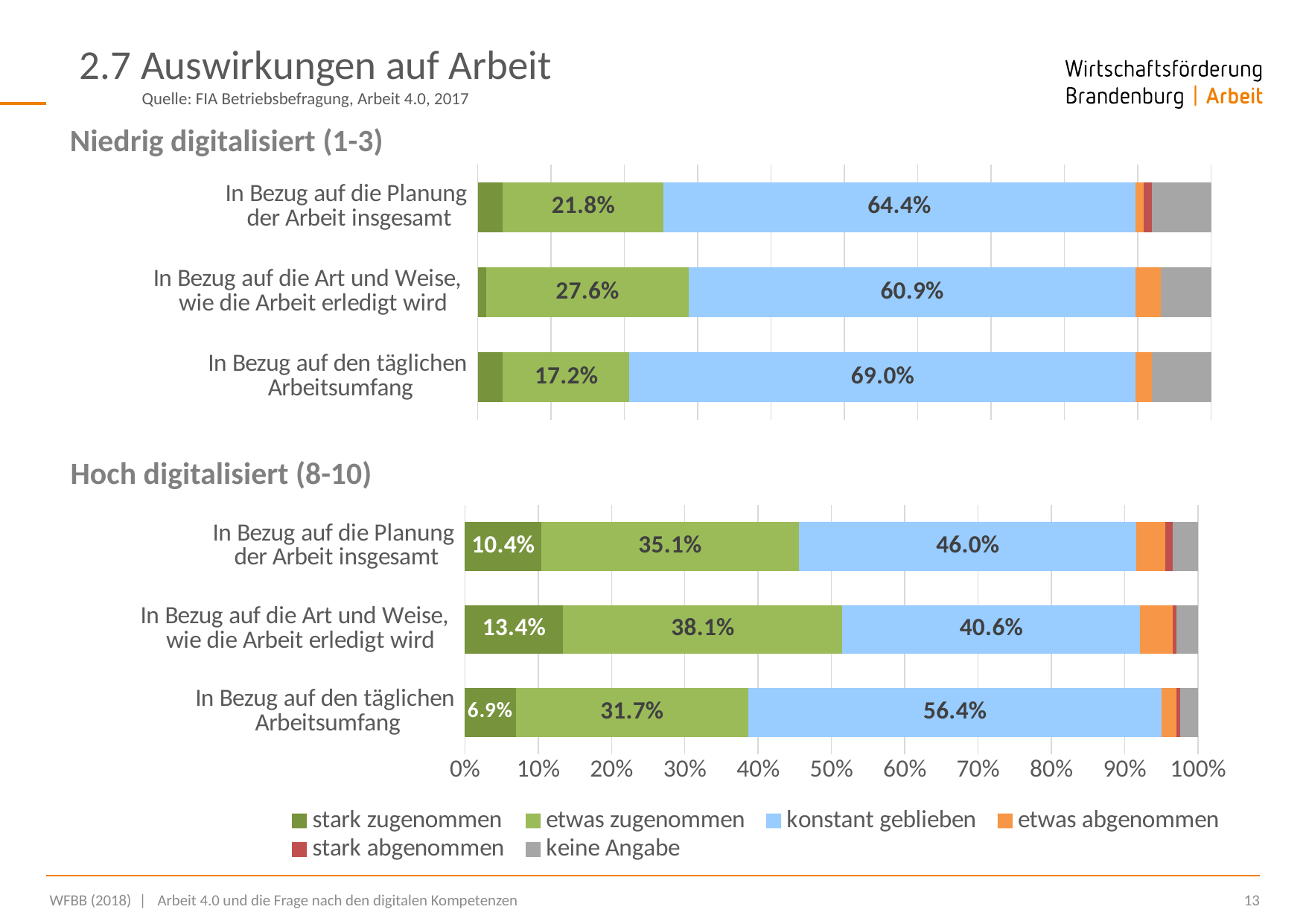
How many series does the legend list? 6 In the 'Hoch digitalisiert (8-10)' chart, which category has the highest value for 'etwas zugenommen'? In Bezug auf die Art und Weise, wie die Arbeit erledigt wird In the 'Niedrig digitalisiert (1-3)' chart, what is the value for 'etwas zugenommen' for 'In Bezug auf die Art und Weise, wie die Arbeit erledigt wird'? 27.6% In the 'Hoch digitalisiert (8-10)' chart, what is the value for 'stark zugenommen' for 'In Bezug auf die Planung der Arbeit insgesamt'? 10.4% In the 'Hoch digitalisiert (8-10)' chart, what is the difference between the 'konstant geblieben' values for 'In Bezug auf den täglichen Arbeitsumfang' and 'In Bezug auf die Planung der Arbeit insgesamt'? 10.4% In the 'Niedrig digitalisiert (1-3)' chart, what is the value for 'konstant geblieben' for 'In Bezug auf den täglichen Arbeitsumfang'? 69.0% How many categories does the 'Hoch digitalisiert (8-10)' chart show? 3 In the 'Hoch digitalisiert (8-10)' chart, what is the value for 'konstant geblieben' for 'In Bezug auf die Art und Weise, wie die Arbeit erledigt wird'? 40.6% What kind of chart is the 'Niedrig digitalisiert (1-3)' chart? Stacked bar chart In the 'Niedrig digitalisiert (1-3)' chart, which category has the lowest value for 'etwas zugenommen'? In Bezug auf den täglichen Arbeitsumfang Is the 'stark zugenommen' value for 'In Bezug auf die Art und Weise, wie die Arbeit erledigt wird' larger in the 'Hoch digitalisiert (8-10)' chart or in the 'Niedrig digitalisiert (1-3)' chart? Hoch digitalisiert (8-10) In the 'Niedrig digitalisiert (1-3)' chart, what is the difference between the 'konstant geblieben' values for 'In Bezug auf den täglichen Arbeitsumfang' and 'In Bezug auf die Art und Weise, wie die Arbeit erledigt wird'? 8.1%